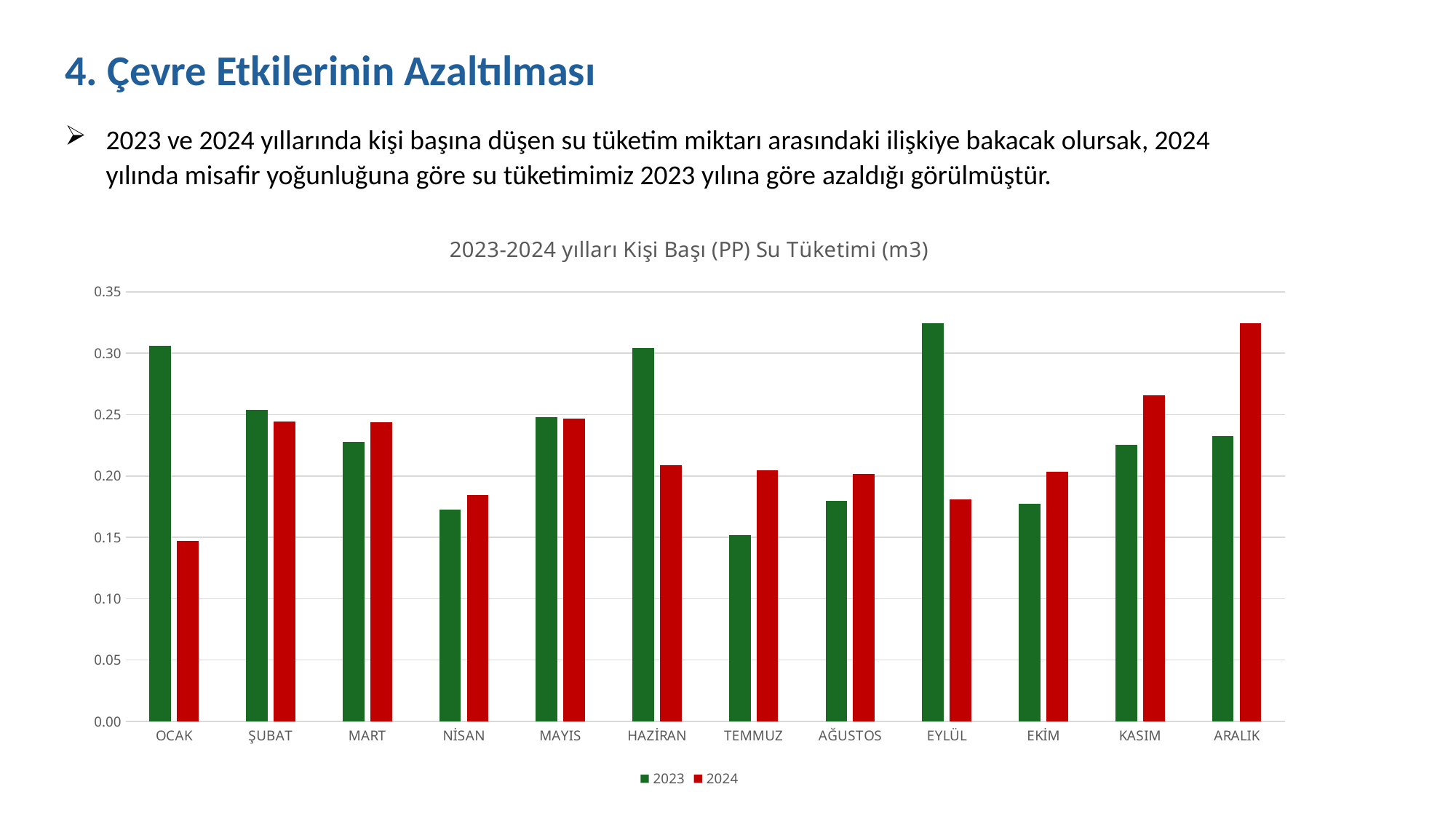
What is the title of the chart? 2023-2024 yılları Kişi Başı (PP) Su Tüketimi (m3) For OCAK, which series has the larger value, 2023 or 2024? 2023 For KASIM, which series has the larger value, 2023 or 2024? 2024 What kind of chart is shown on the slide? bar chart Which month has the lowest value for the 2023 series? TEMMUZ Is the 2024 value for ARALIK greater or less than 0.30? greater How many months are shown on the x axis of the chart? 12 Is the 2024 value for HAZİRAN greater or less than 0.25? less Which month has the highest value for the 2023 series? EYLÜL Which month has the highest value for the 2024 series? ARALIK Which month has the lowest value for the 2024 series? OCAK How many series does the legend list? 2